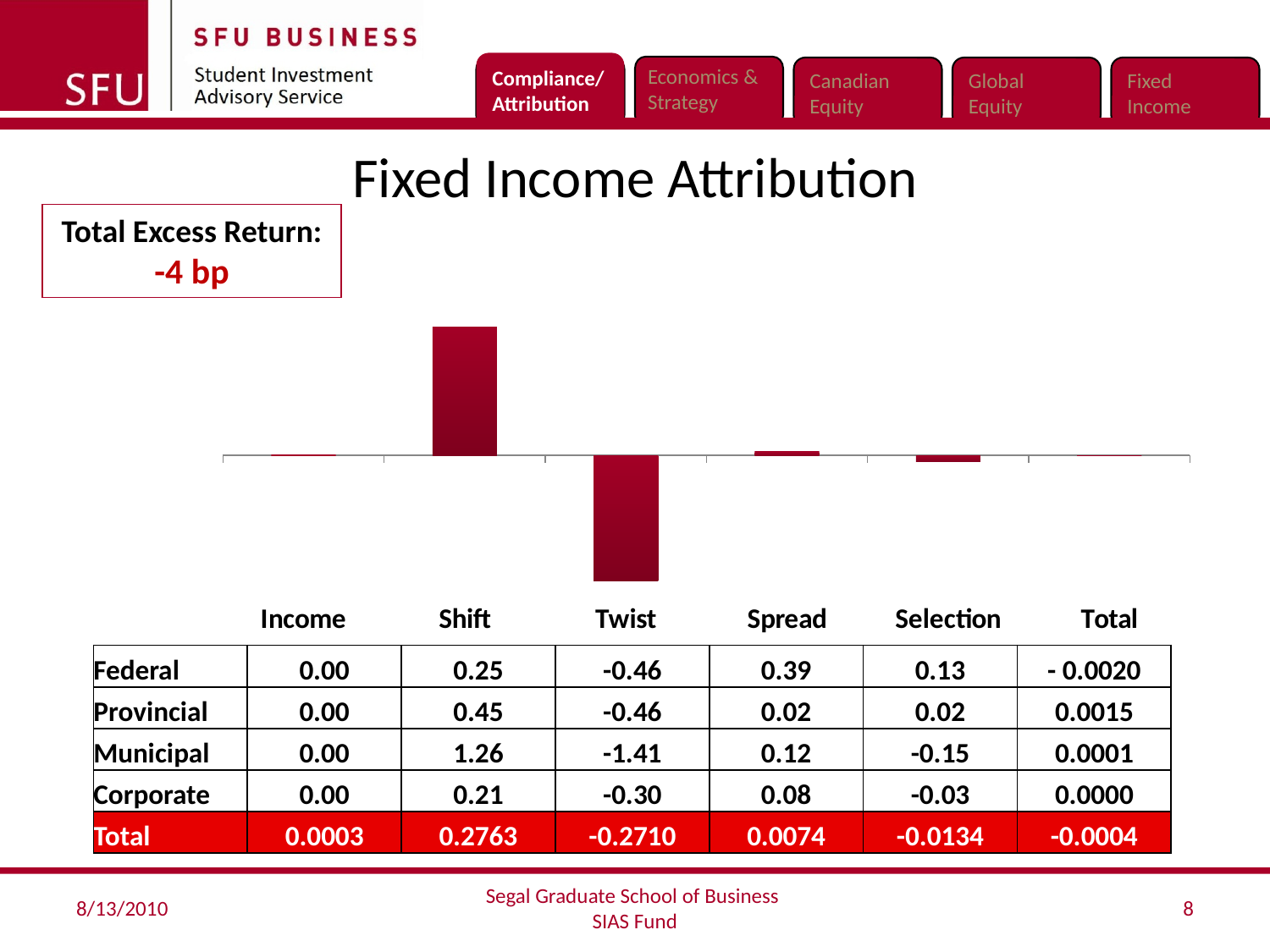
Which bar is taller, Shift or Spread? Shift What is the title of the slide containing the chart? Fixed Income Attribution Is the bar for Twist above or below the zero baseline? below What kind of chart is shown on the slide? bar chart What is the Total value plotted for Selection, as printed in the table? -0.0134 Which category has the highest bar in the chart? Shift Is the bar for Spread above or below the zero baseline? above Which category has the lowest bar in the chart? Twist What Total Excess Return is stated in the box next to the chart? -4 bp What is the Total value plotted for Twist, as printed in the table? -0.2710 How many bars are plotted in the chart? 6 What is the Total value plotted for Shift, as printed in the table? 0.2763